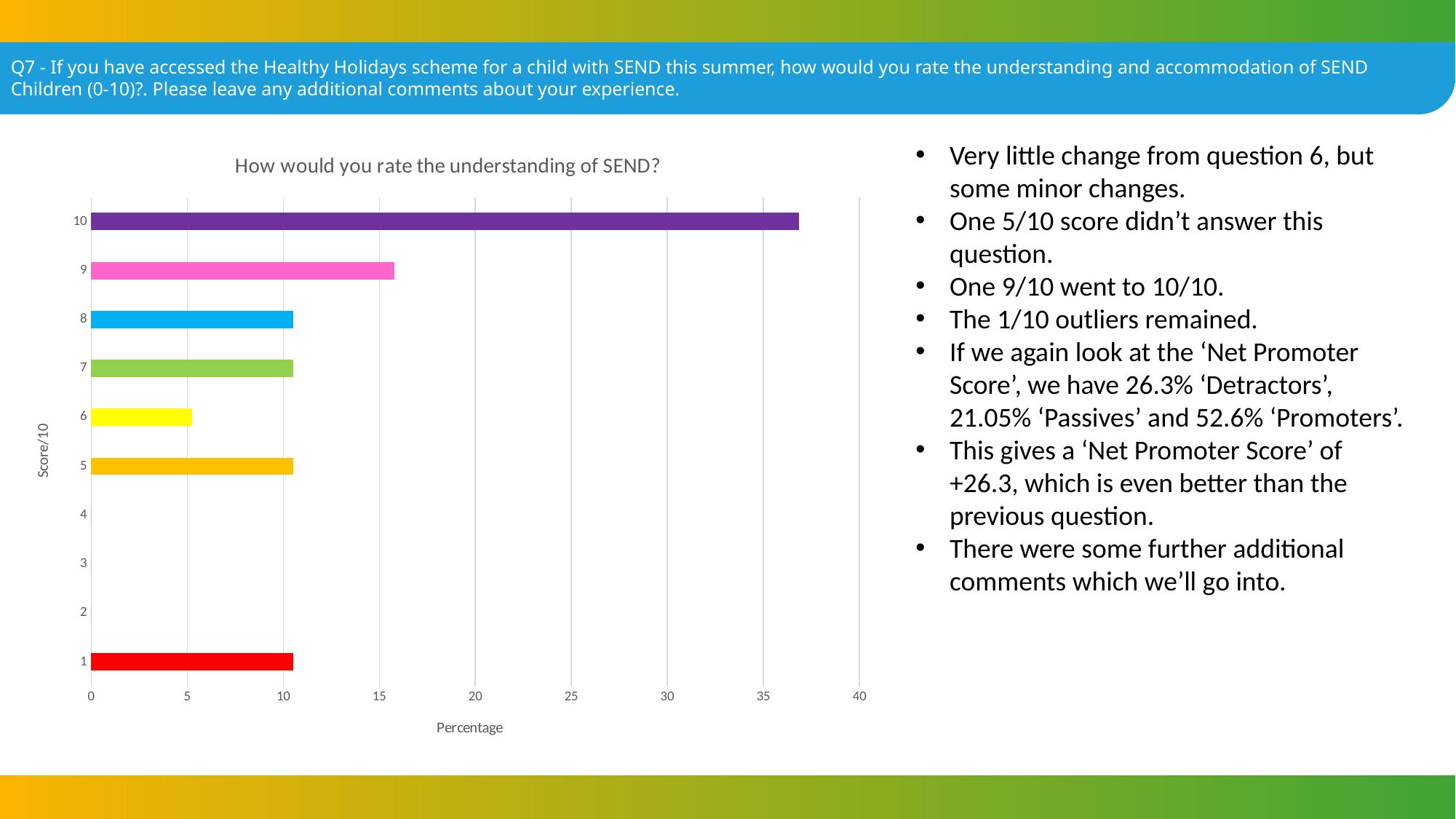
Is the value for score 6 greater or less than 10? less What is the label on the horizontal axis of the chart? Percentage Is the value for score 8 greater or less than 15? less Which has the larger value, score 5 or score 6? score 5 What kind of chart is shown on the slide? bar chart Which has the larger value, score 9 or score 8? score 9 How many score categories are listed on the vertical axis of the chart? 10 Is the value for score 9 greater or less than 20? less What is the title of the chart? How would you rate the understanding of SEND? Which score has the longest bar in the chart? 10 How many scores in the chart have no bar at all (a value of zero)? 3